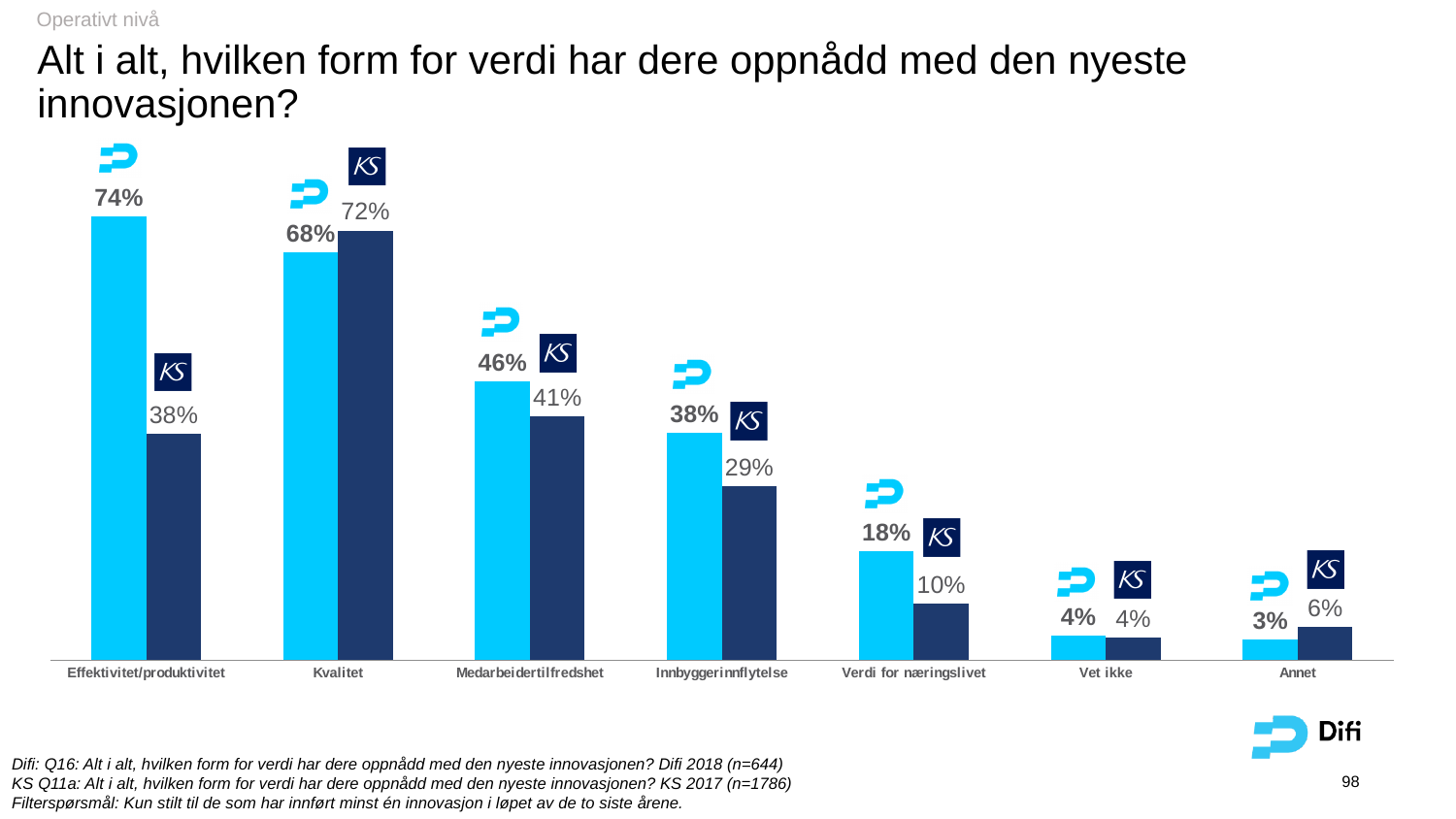
What is the difference between the Difi and KS values for Effektivitet/produktivitet? 36 percentage points What is the Difi value for Verdi for næringslivet? 18% For Kvalitet, which is larger: the Difi value or the KS value? KS How many series are plotted in the chart? 2 How many categories are shown on the x axis? 7 Which category has the highest Difi value? Effektivitet/produktivitet What is the KS value for Kvalitet? 72% What is the KS value for Innbyggerinnflytelse? 29% What is the difference between the Difi and KS values for Medarbeidertilfredshet? 5 percentage points What kind of chart is shown on the slide? Bar chart What is the Difi value for Effektivitet/produktivitet? 74% Which category has the lowest Difi value? Annet